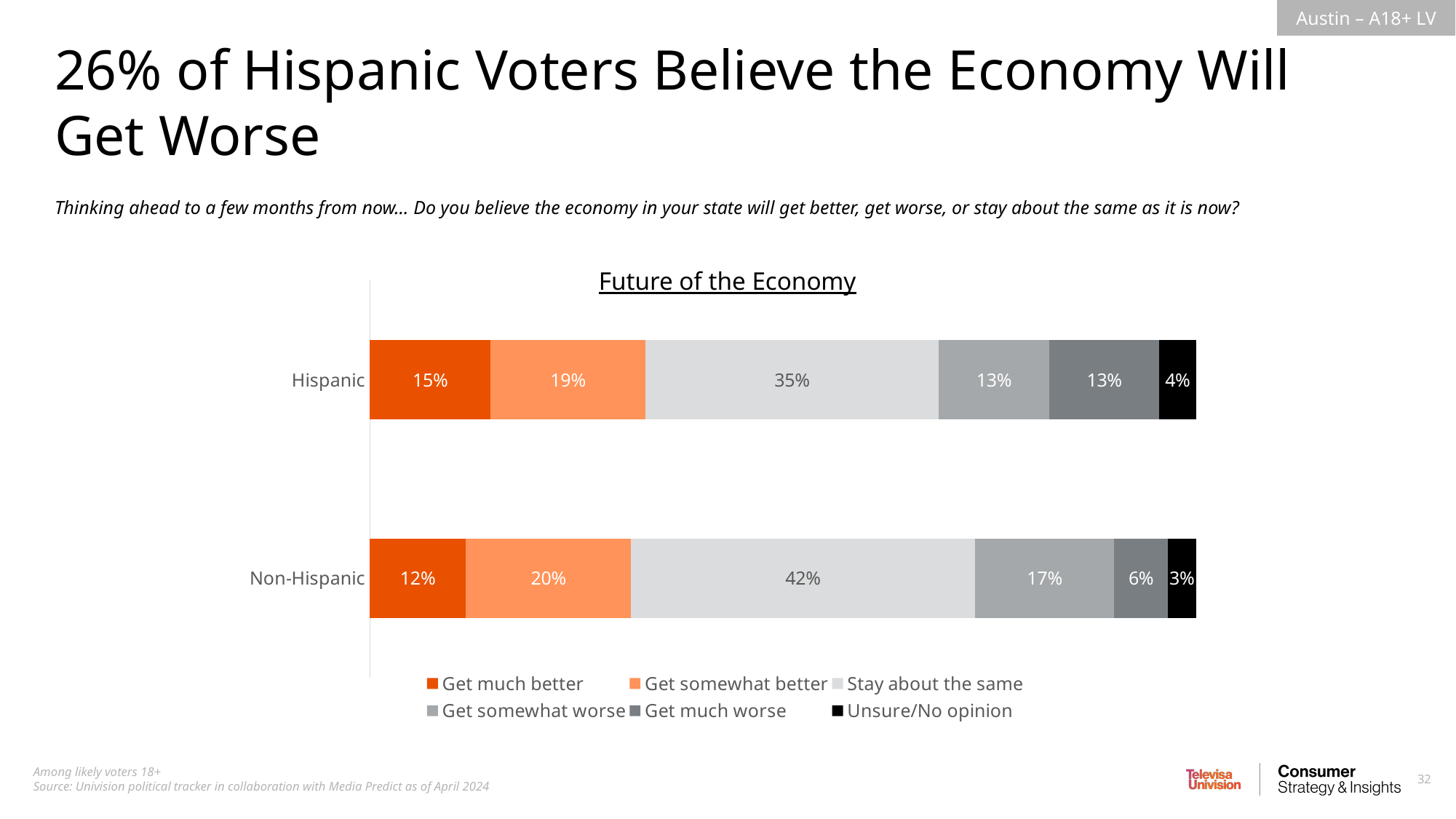
How many groups (bars) are shown in the chart? 2 What percentage of Non-Hispanic voters are unsure or have no opinion? 3% Which response category has the smallest share among Hispanic voters? Unsure/No opinion What is the combined share of Hispanic voters who say the economy will get somewhat worse or much worse? 26% What percentage of Hispanic voters say the economy will get much worse? 13% How many series does the legend list? 6 Which group has a larger share saying the economy will get much worse, Hispanic or Non-Hispanic? Hispanic What percentage of Non-Hispanic voters say the economy will get much better? 12% What type of chart is shown on the slide? Stacked bar chart Which response category has the largest share among Non-Hispanic voters? Stay about the same What percentage of Hispanic voters say the economy will stay about the same? 35% What is the difference between the Non-Hispanic and Hispanic shares for 'Stay about the same'? 7%